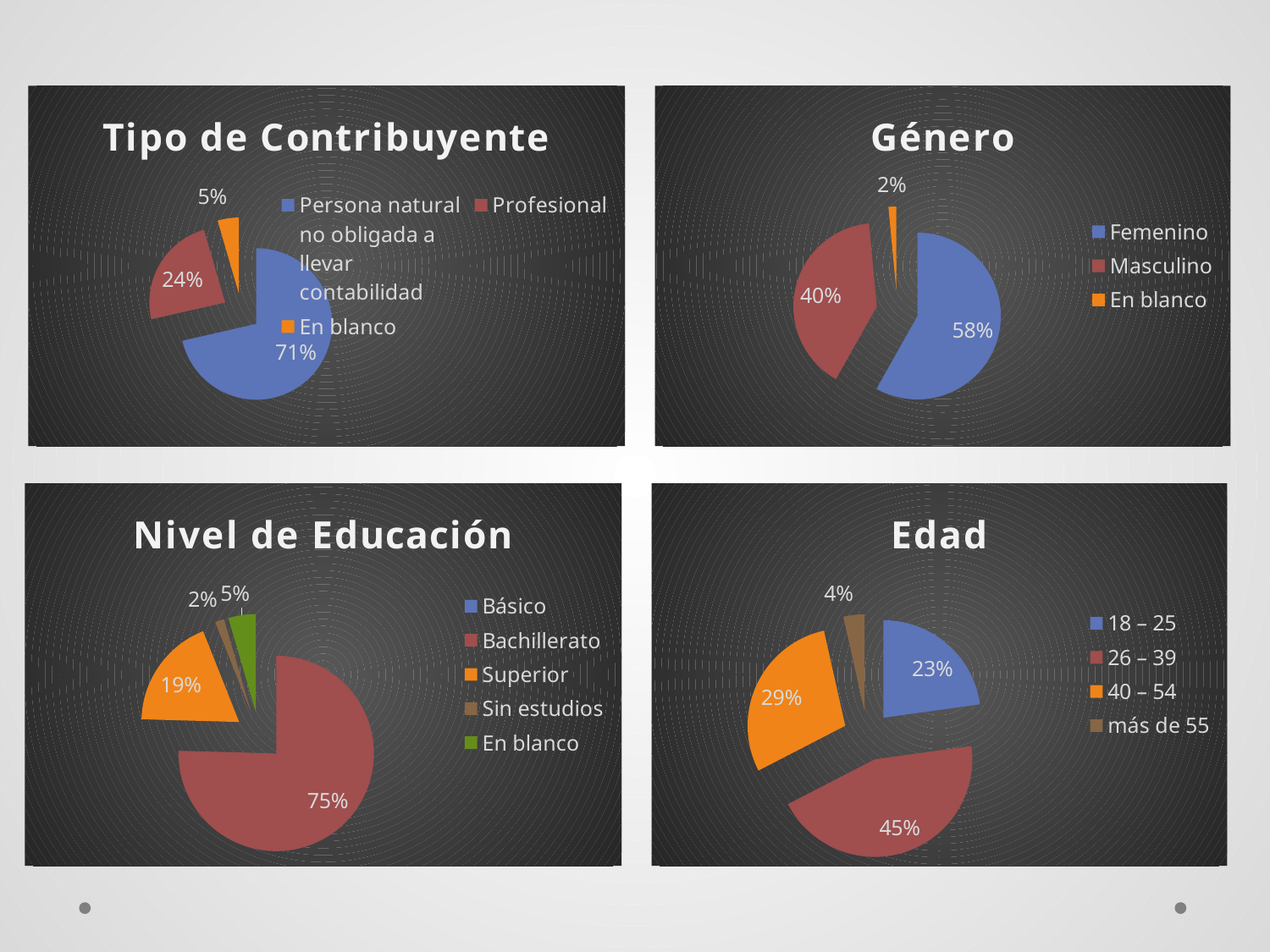
In the 'Género' chart, what percentage is Femenino? 58% In the 'Nivel de Educación' chart, what percentage is Bachillerato? 75% In the 'Tipo de Contribuyente' chart, which category has the largest share? Persona natural no obligada a llevar contabilidad In the 'Género' chart, what percentage is Masculino? 40% In the 'Género' chart, what is the difference between Femenino and Masculino? 18% How many categories does the legend of the 'Nivel de Educación' chart list? 5 In the 'Tipo de Contribuyente' chart, what percentage is Profesional? 24% In the 'Nivel de Educación' chart, which is larger, Bachillerato or Superior? Bachillerato What kind of chart is the 'Edad' chart? Pie chart In the 'Edad' chart, which age group has the smallest share? más de 55 In the 'Edad' chart, what percentage is the 26 – 39 group? 45% In the 'Edad' chart, what is the difference between the 40 – 54 share and the 18 – 25 share? 6%